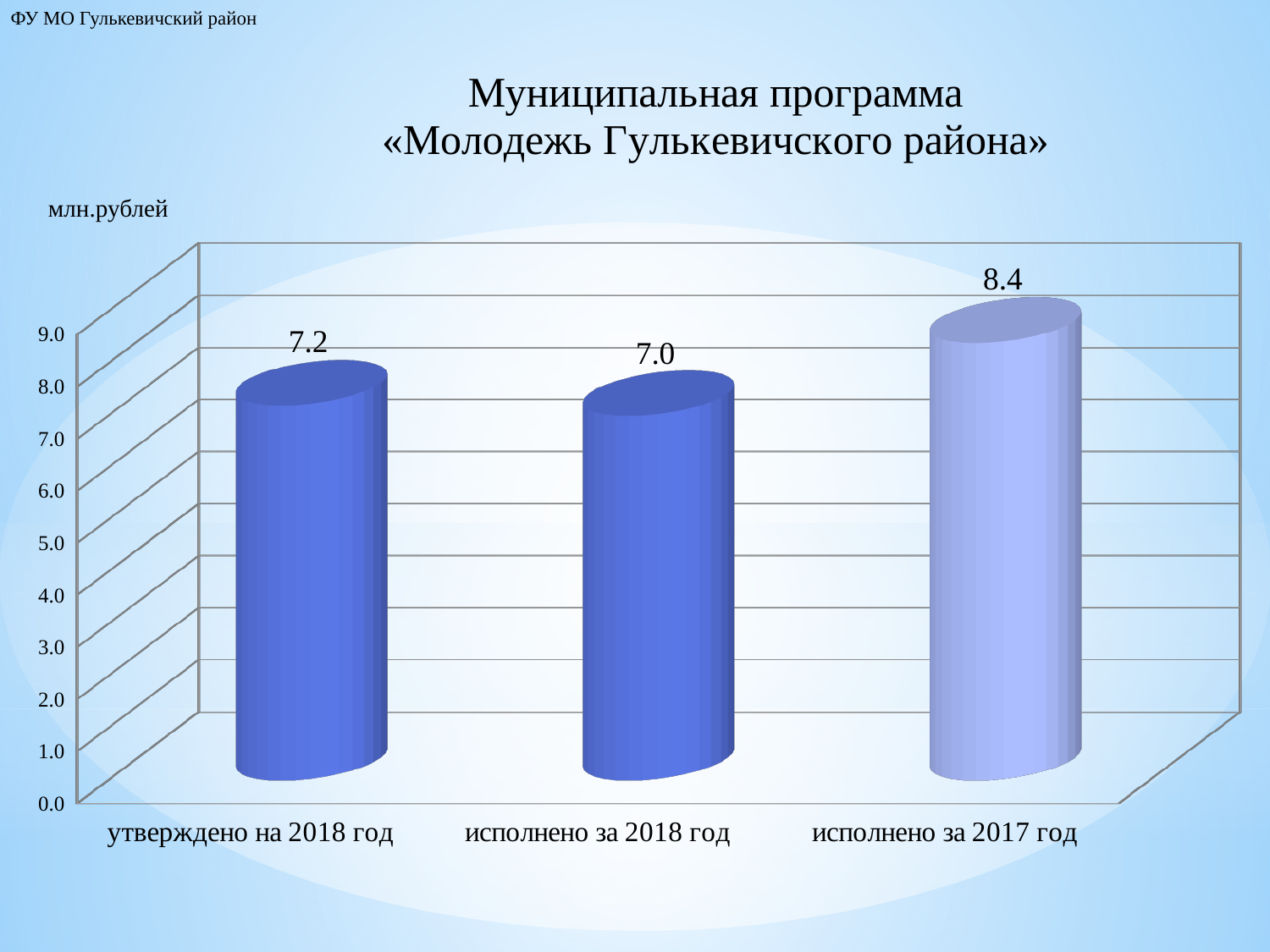
Is the value for «исполнено за 2017 год» greater or less than 8.0? greater What is the difference between the values for «утверждено на 2018 год» and «исполнено за 2018 год»? 0.2 What is the difference between the values for «исполнено за 2017 год» and «исполнено за 2018 год»? 1.4 What is the value for «исполнено за 2018 год»? 7.0 What is the value for «исполнено за 2017 год»? 8.4 Which category has the highest value? исполнено за 2017 год What kind of chart is shown on the slide? bar chart How many categories are shown in the chart? 3 Which is larger: the value for «утверждено на 2018 год» or for «исполнено за 2017 год»? исполнено за 2017 год What unit is indicated for the values in the chart? млн.рублей What is the value for «утверждено на 2018 год»? 7.2 Which category has the lowest value? исполнено за 2018 год